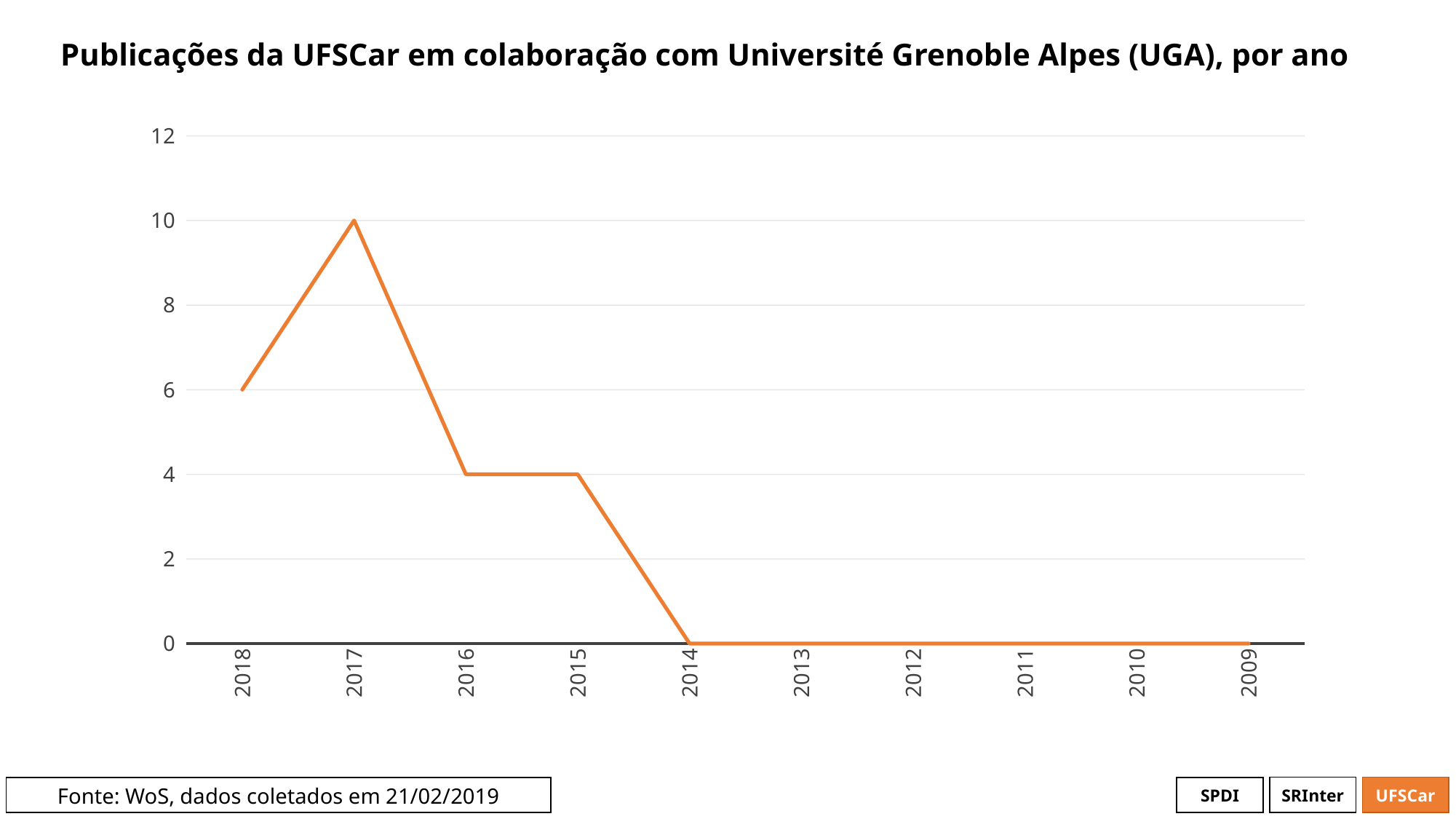
What is the value for 2014? 0 What kind of chart is shown on the slide? line chart How many years are shown on the x axis? 10 What is the difference between the values for 2017 and 2018? 4 Which is larger, the value for 2018 or the value for 2016? 2018 What is the value for 2018? 6 What is the value for 2016? 4 What is the value for 2017? 10 Which year has the highest value? 2017 Do the values rise or fall from 2017 to 2014 along the x axis? fall Is the value for 2017 greater or less than 8? greater What is the title of the chart? Publicações da UFSCar em colaboração com Université Grenoble Alpes (UGA), por ano